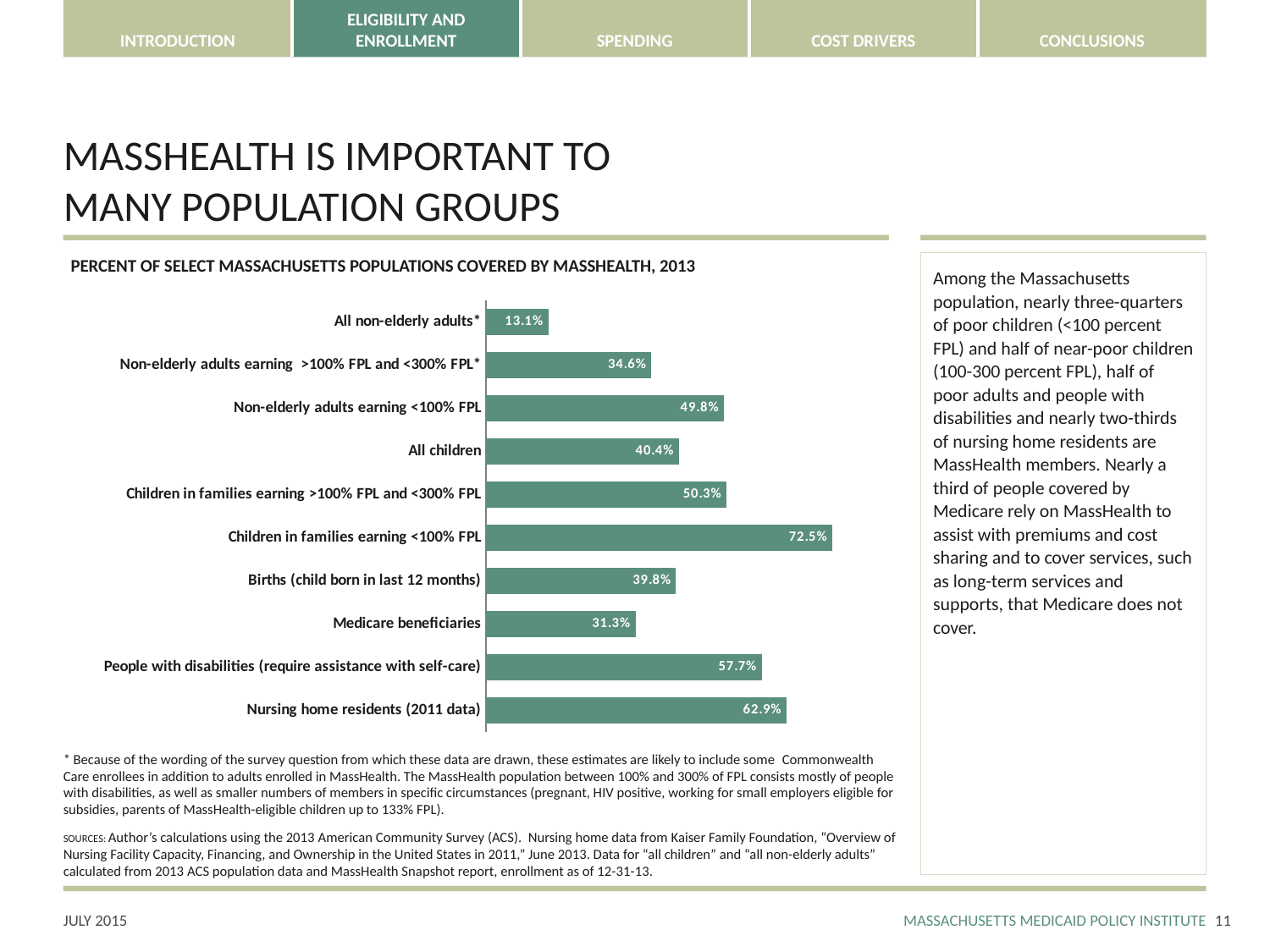
What is the difference between the values for children in families earning <100% FPL and all children? 32.1% What is the value shown for Medicare beneficiaries? 31.3% What kind of chart is shown on the slide? Bar chart What percent of children in families earning <100% FPL are covered by MassHealth? 72.5% What percent of nursing home residents (2011 data) are covered by MassHealth? 62.9% What is the title of the chart? Percent of select Massachusetts populations covered by MassHealth, 2013 Which is larger: the value for people with disabilities (require assistance with self-care) or the value for nursing home residents (2011 data)? Nursing home residents (2011 data) How many population groups are shown in the chart? 10 Which population group has the lowest percentage covered by MassHealth? All non-elderly adults* What is the value shown for births (child born in last 12 months)? 39.8% What is the difference between the values for non-elderly adults earning <100% FPL and all non-elderly adults*? 36.7% Which population group has the highest percentage covered by MassHealth? Children in families earning <100% FPL